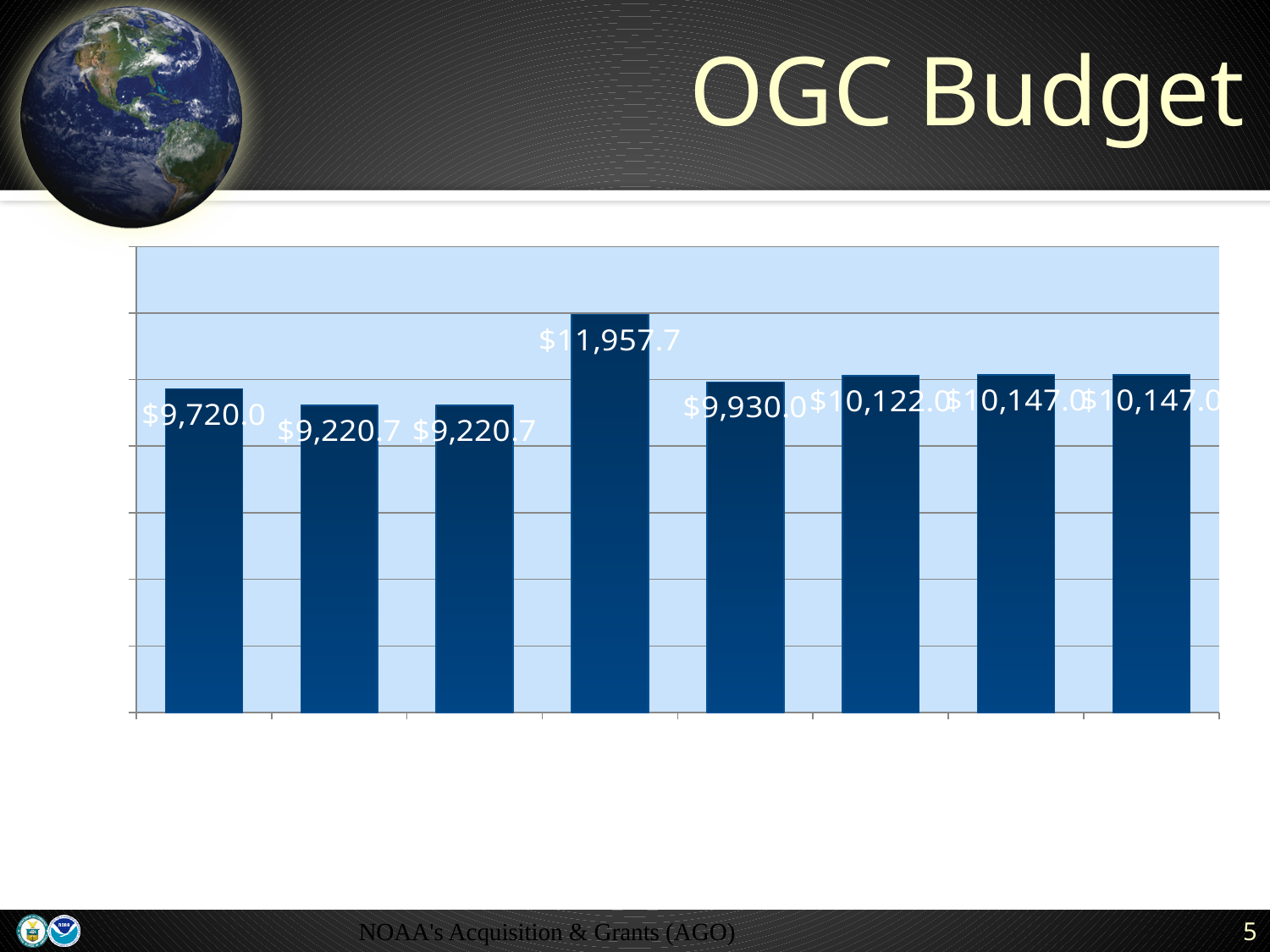
What is the value labelled on the last (rightmost) bar? $10,147.0 What is the title of the slide's chart? OGC Budget What is the highest value shown in the chart? $11,957.7 What is the difference between the fourth bar ($11,957.7) and the first bar ($9,720.0)? $2,237.7 What kind of chart is shown on the slide? bar chart How many bars are plotted in the chart? 8 What is the lowest value shown in the chart? $9,220.7 What is the value labelled on the first (leftmost) bar? $9,720.0 What is the value labelled on the fourth bar from the left? $11,957.7 What colour are the bars in the chart? dark blue What is the value labelled on the fifth bar from the left? $9,930.0 Which is larger, the fifth bar or the sixth bar from the left? the sixth bar ($10,122.0)